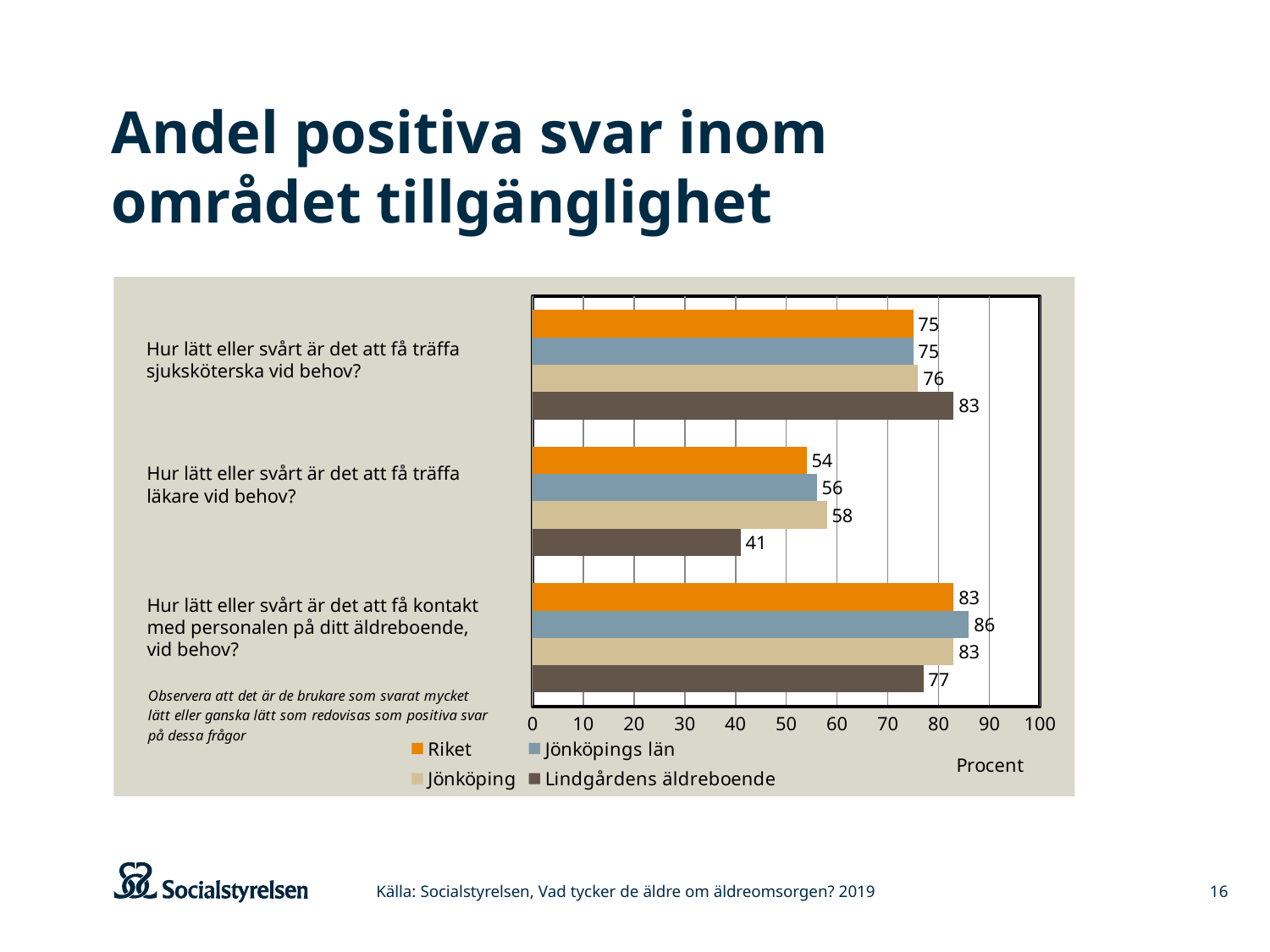
What is the value for Jönköpings län for "Hur lätt eller svårt är det att få kontakt med personalen på ditt äldreboende, vid behov?"? 86 Which series has the lowest value for "Hur lätt eller svårt är det att få träffa läkare vid behov?"? Lindgårdens äldreboende What is the difference between Jönköping and Lindgårdens äldreboende for "Hur lätt eller svårt är det att få träffa läkare vid behov?"? 17 Which series has the highest value for "Hur lätt eller svårt är det att få träffa sjuksköterska vid behov?"? Lindgårdens äldreboende How many series does the legend list? 4 What is the label of the x axis? Procent How many question categories are plotted on the chart? 3 What is the value for Riket for "Hur lätt eller svårt är det att få träffa läkare vid behov?"? 54 What is the value for Lindgårdens äldreboende for "Hur lätt eller svårt är det att få träffa sjuksköterska vid behov?"? 83 Is the value for Lindgårdens äldreboende for "Hur lätt eller svårt är det att få träffa läkare vid behov?" greater or less than 50? less For "Hur lätt eller svårt är det att få kontakt med personalen på ditt äldreboende, vid behov?", which is larger: Jönköpings län or Lindgårdens äldreboende? Jönköpings län What kind of chart is shown on the slide? Bar chart